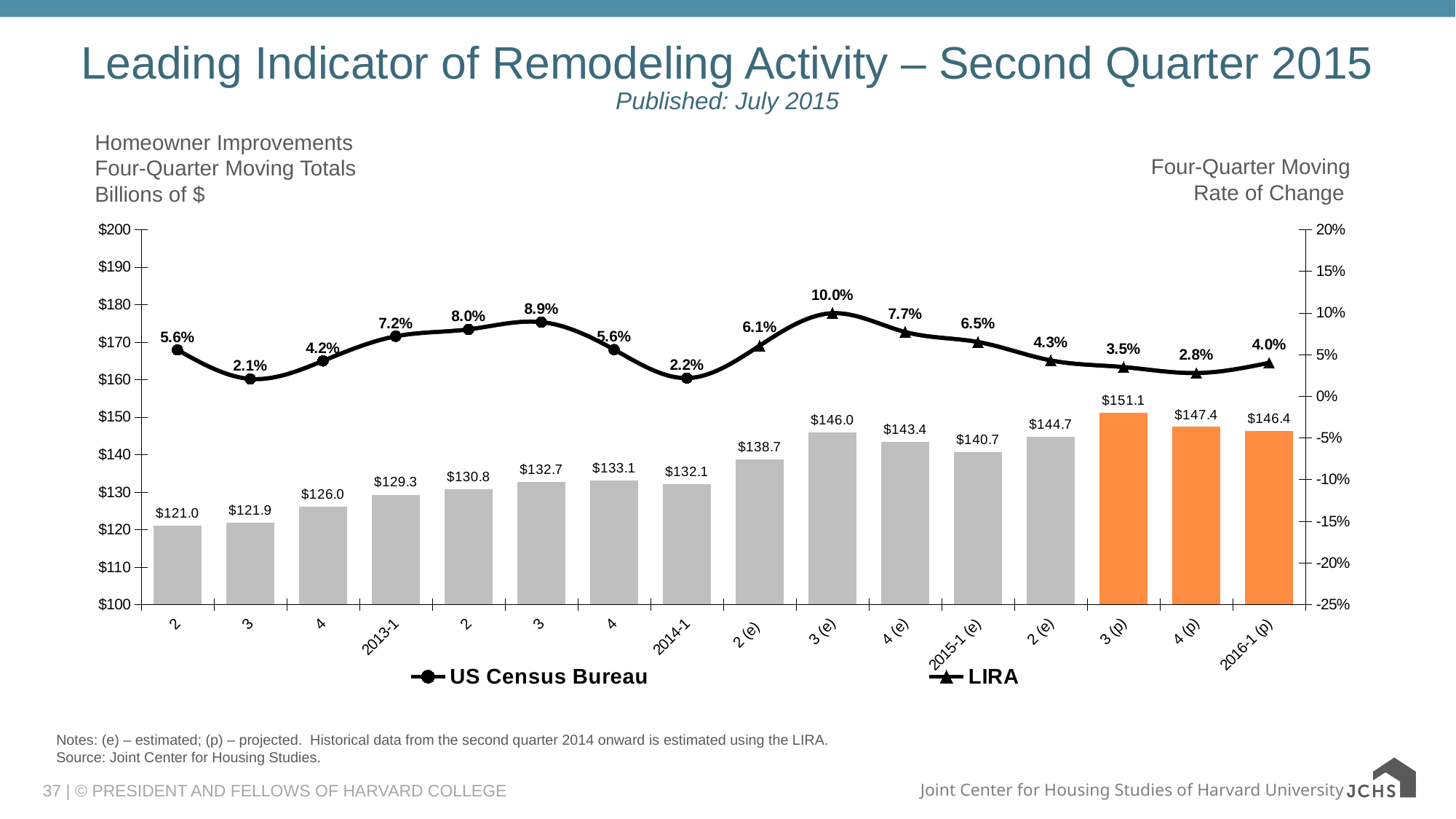
What is the value of the leftmost bar? $121.0 Which bar is larger, 2015-1 (e) or the 2 (e) bar immediately after it? 2 (e) What is the value of the bar for 2016-1 (p)? $146.4 What is the four-quarter moving rate of change shown for 2014-1? 2.2% What kind of chart is shown on the slide? Combination bar and line chart What is the value of the bar for 2013-1? $129.3 What is the lowest rate of change shown on the line? 2.1% How many series does the legend list? 2 What is the difference between the bar values for 3 (p) and 2016-1 (p)? $4.7 Which category has the highest bar value? 3 (p) How many bars are plotted on the chart? 16 What is the highest rate of change shown on the line, and at which category? 10.0% at 3 (e)